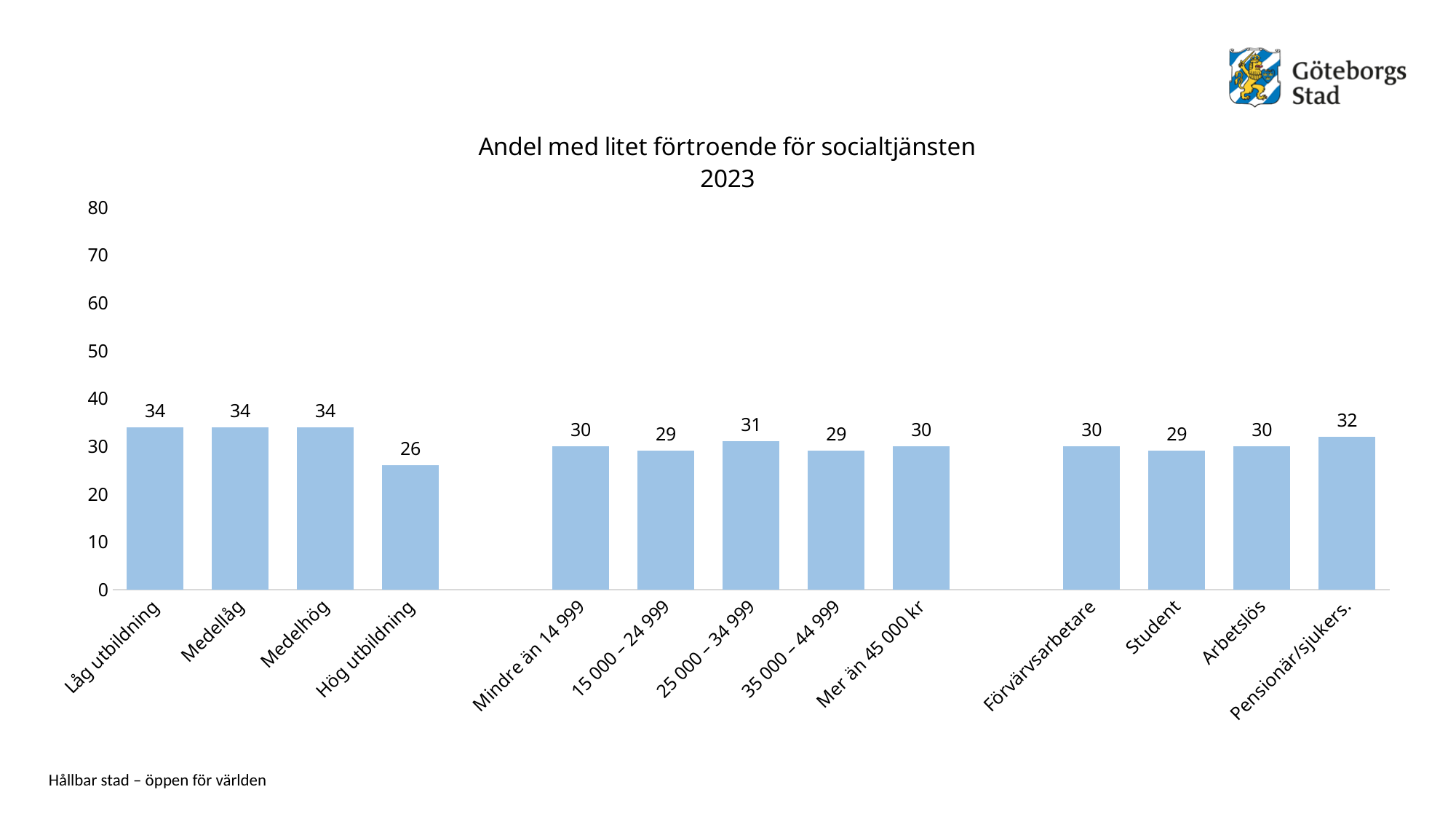
Which is larger, the value for Pensionär/sjukers. or the value for Arbetslös? Pensionär/sjukers. What is the value for Student? 29 Which category has the lowest value? Hög utbildning How many categories are shown in the chart? 13 What is the difference between the values for Låg utbildning and Hög utbildning? 8 Is the value for Medelhög greater or less than 30? greater What kind of chart is shown on the slide? Bar chart What is the title of the chart? Andel med litet förtroende för socialtjänsten 2023 What is the value for Pensionär/sjukers.? 32 What is the value for Hög utbildning? 26 What is the value for 25 000 – 34 999? 31 What is the highest value shown in the chart? 34